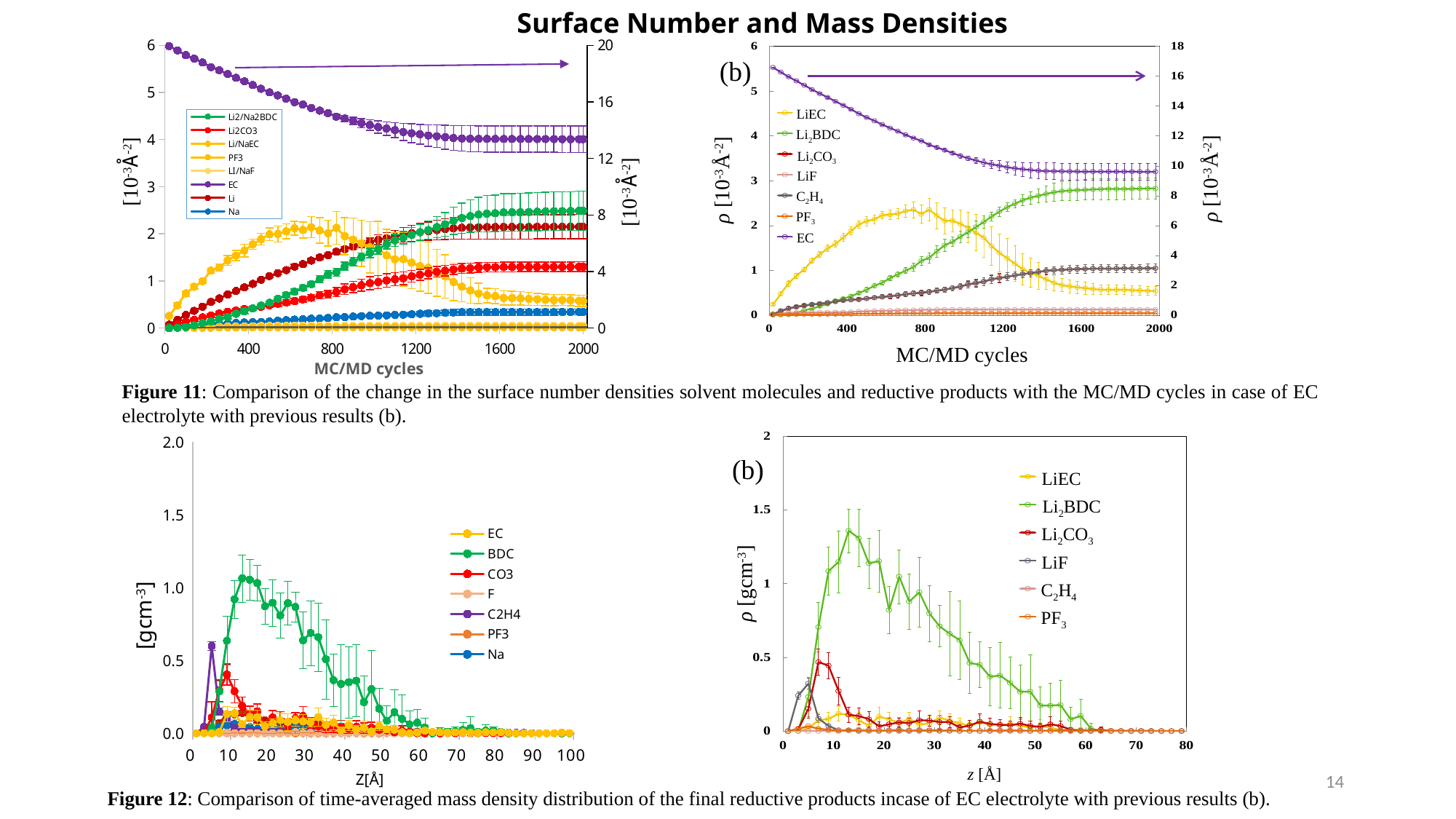
How many series does the legend of the top-left chart (Figure 11, left) list? 8 In the top-right chart (Figure 11 b), is the value of Li2BDC at 2000 MC/MD cycles greater or less than 2 on the left axis? greater How many series does the legend of the bottom-left chart (Figure 12, left) list? 7 How many series does the legend of the bottom-right chart (Figure 12 b) list? 6 In the top-right chart (Figure 11 b), which is larger at 2000 MC/MD cycles, Li2BDC or Li2CO3? Li2BDC In the bottom-left chart (Figure 12, left), which series reaches the highest peak value? BDC In the bottom-right chart (Figure 12 b), which series reaches the highest peak value? Li2BDC In the top-right chart (Figure 11 b), does the Li2BDC series rise or fall as the MC/MD cycles increase? rise What kind of chart is the top-right chart labelled (b) in Figure 11? line chart In the top-right chart (Figure 11 b), does the EC series rise or fall as the MC/MD cycles increase? fall In the bottom-left chart (Figure 12, left), is the peak value of the BDC series greater or less than 1.5? less